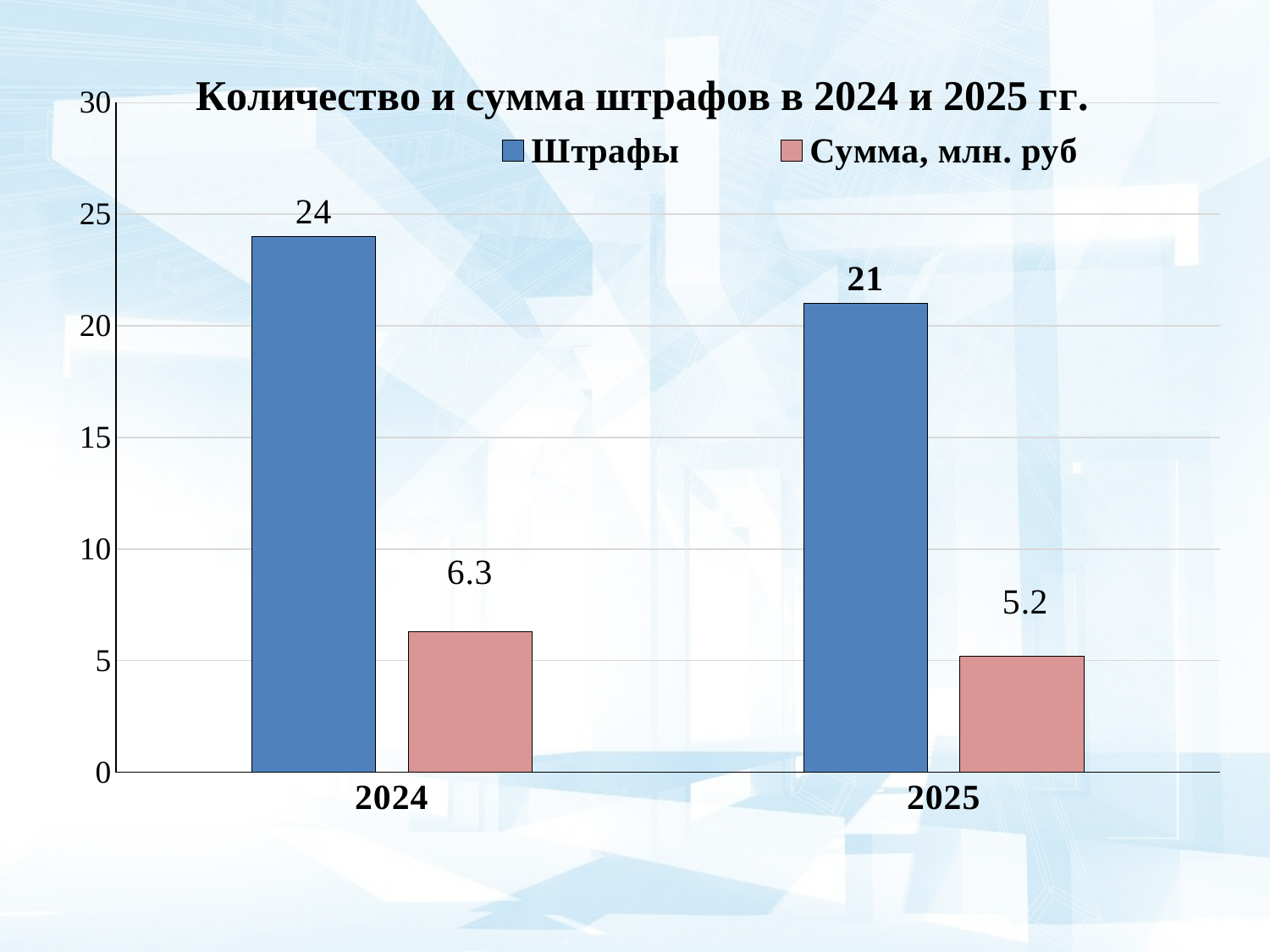
Is the value of Штрафы for 2025 greater or less than 20? greater What is the title of the chart? Количество и сумма штрафов в 2024 и 2025 гг. What is the value of Штрафы for 2025? 21 What is the value of Штрафы for 2024? 24 What is the difference between the Штрафы values for 2024 and 2025? 3 What kind of chart is shown on the slide? Bar chart How many series does the legend list? 2 What is the value of Сумма, млн. руб for 2024? 6.3 What is the difference between the Сумма, млн. руб values for 2024 and 2025? 1.1 Which year has the lower value for Сумма, млн. руб? 2025 Which year has the higher value for Штрафы? 2024 What is the value of Сумма, млн. руб for 2025? 5.2